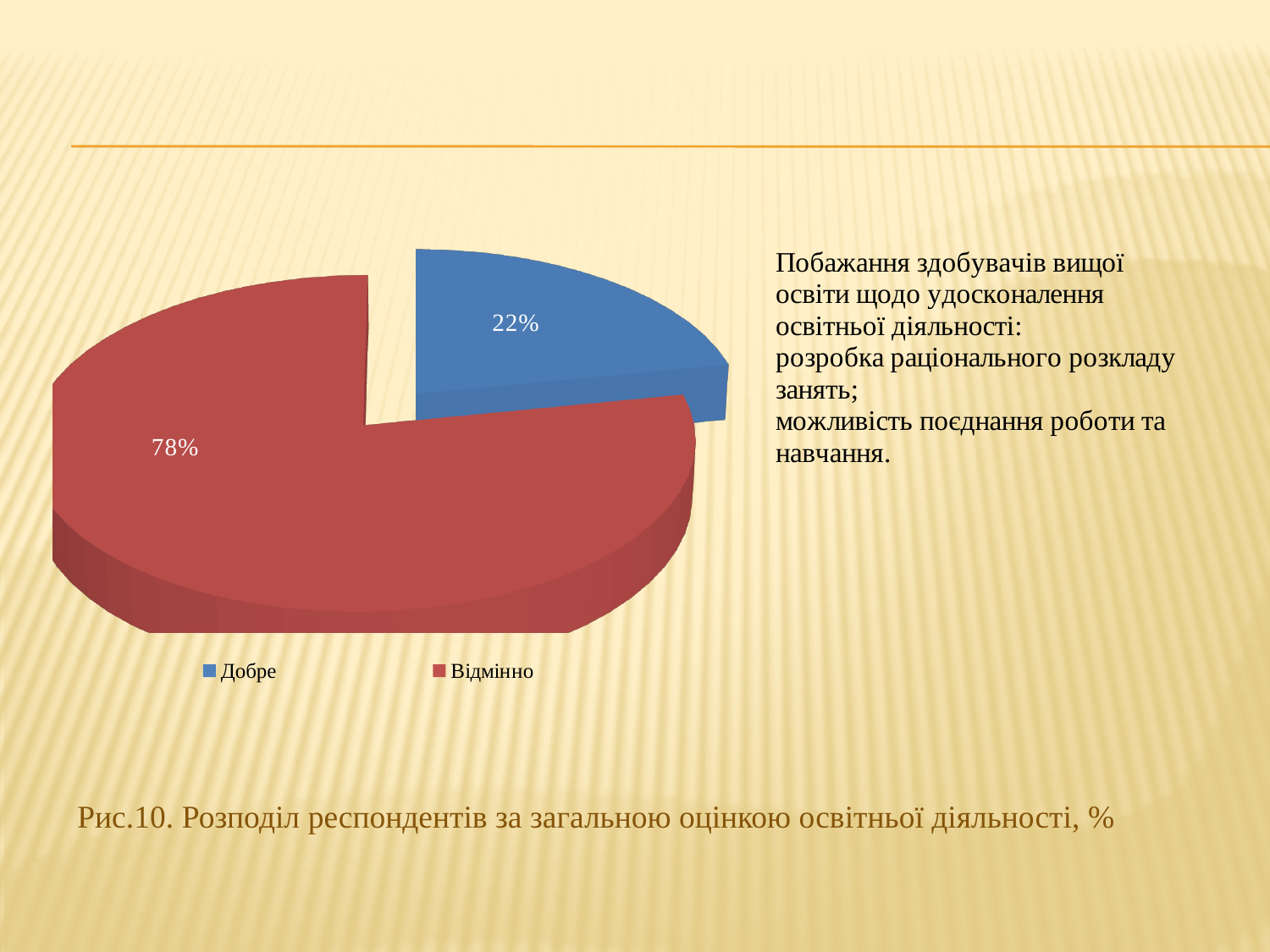
How many categories does the pie chart show? 2 What is the difference in percentage points between the "Відмінно" and "Добре" slices? 56 How many entries does the legend list? 2 Is the share for "Добре" greater or less than 50%? less What share of respondents rated the educational activity as "Добре"? 22% What colour is the "Добре" slice? blue Which category has the largest slice of the pie? Відмінно Which slice is larger, "Добре" or "Відмінно"? Відмінно What share of respondents rated the educational activity as "Відмінно"? 78% What colour is the "Відмінно" slice? red What kind of chart is shown on the slide? pie chart Which category has the smallest slice of the pie? Добре